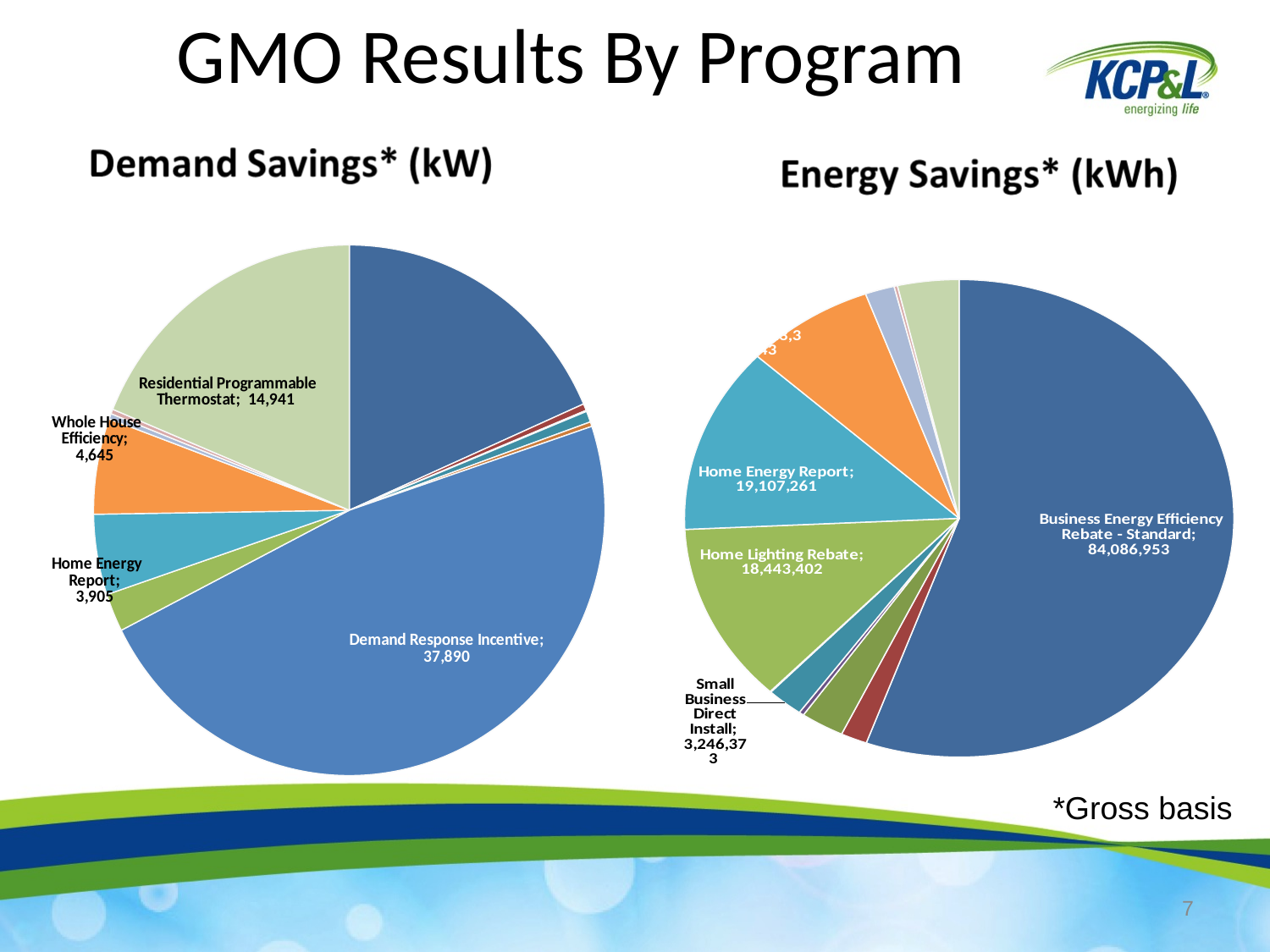
In the Demand Savings* (kW) pie chart, what is the value for Residential Programmable Thermostat? 14,941 In the Energy Savings* (kWh) pie chart, which is larger, Home Energy Report or Home Lighting Rebate? Home Energy Report What type of chart is used for Demand Savings* (kW)? Pie chart In the Demand Savings* (kW) pie chart, what is the value for Demand Response Incentive? 37,890 In the Energy Savings* (kWh) pie chart, what is the value for Business Energy Efficiency Rebate - Standard? 84,086,953 In the Demand Savings* (kW) pie chart, what is the difference between Demand Response Incentive and Residential Programmable Thermostat? 22,949 In the Demand Savings* (kW) pie chart, which labelled program has the largest slice? Demand Response Incentive In the Energy Savings* (kWh) pie chart, what is the difference between Home Energy Report and Home Lighting Rebate? 663,859 In the Energy Savings* (kWh) pie chart, which program has the largest slice? Business Energy Efficiency Rebate - Standard In the Demand Savings* (kW) pie chart, what is the value for Whole House Efficiency? 4,645 In the Energy Savings* (kWh) pie chart, what is the value for Small Business Direct Install? 3,246,373 In the Demand Savings* (kW) pie chart, which is larger, Whole House Efficiency or Home Energy Report? Whole House Efficiency